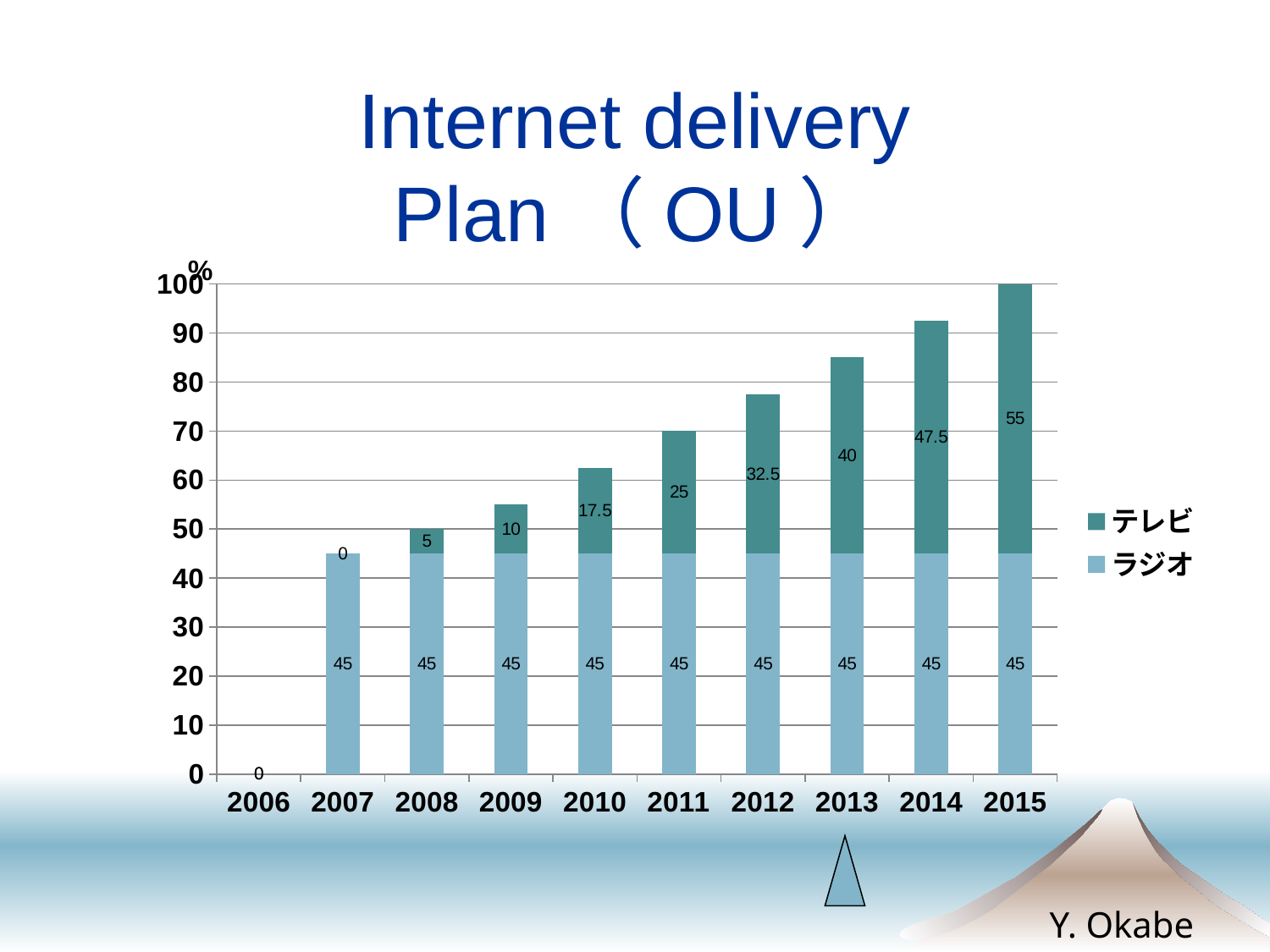
What is the value for テレビ in 2012? 32.5 What is the total of the stacked bar for 2013? 85 What kind of chart is shown on the slide? Stacked bar chart How many years are shown on the x axis? 10 What is the value for ラジオ in 2010? 45 Which is larger, the テレビ value in 2014 or the ラジオ value in 2014? テレビ What is the value for テレビ in 2008? 5 How many series does the legend list? 2 In which year is the テレビ value highest? 2015 What is the difference between the テレビ values for 2015 and 2011? 30 Do the テレビ values rise or fall from 2007 to 2015? Rise What is the total of the stacked bar for 2015? 100